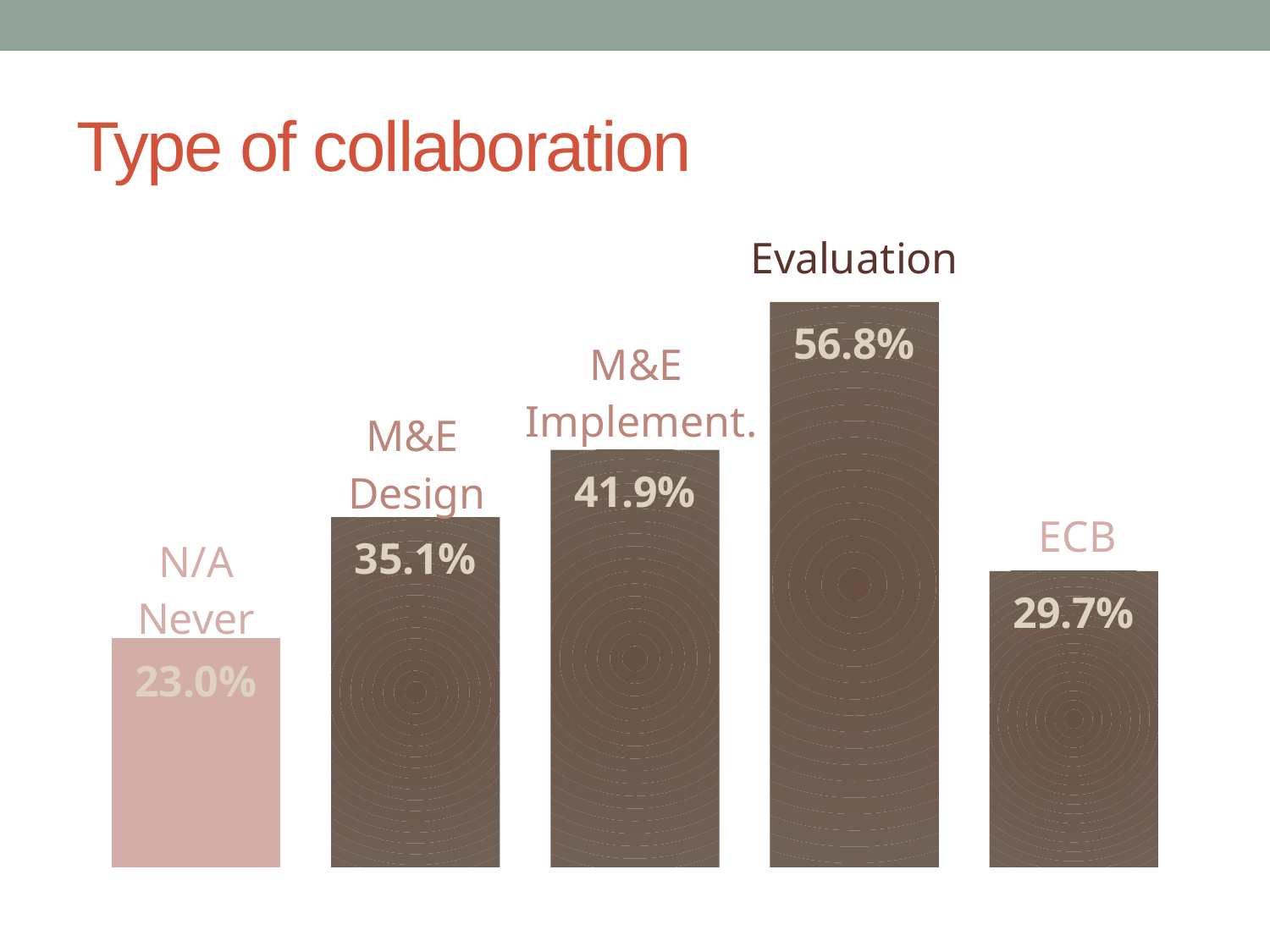
What is the value for M&E Design? 35.1% What is the value for N/A Never? 23.0% What is the value for ECB? 29.7% What is the difference between the values for Evaluation and M&E Implement.? 14.9% What is the difference between the values for M&E Design and ECB? 5.4% What is the title of the slide? Type of collaboration Which category has the lowest value? N/A Never Which is larger, the value for M&E Implement. or the value for ECB? M&E Implement. How many categories are shown in the chart? 5 What kind of chart is shown on the slide? Bar chart What is the value for Evaluation? 56.8% Which category has the highest value? Evaluation